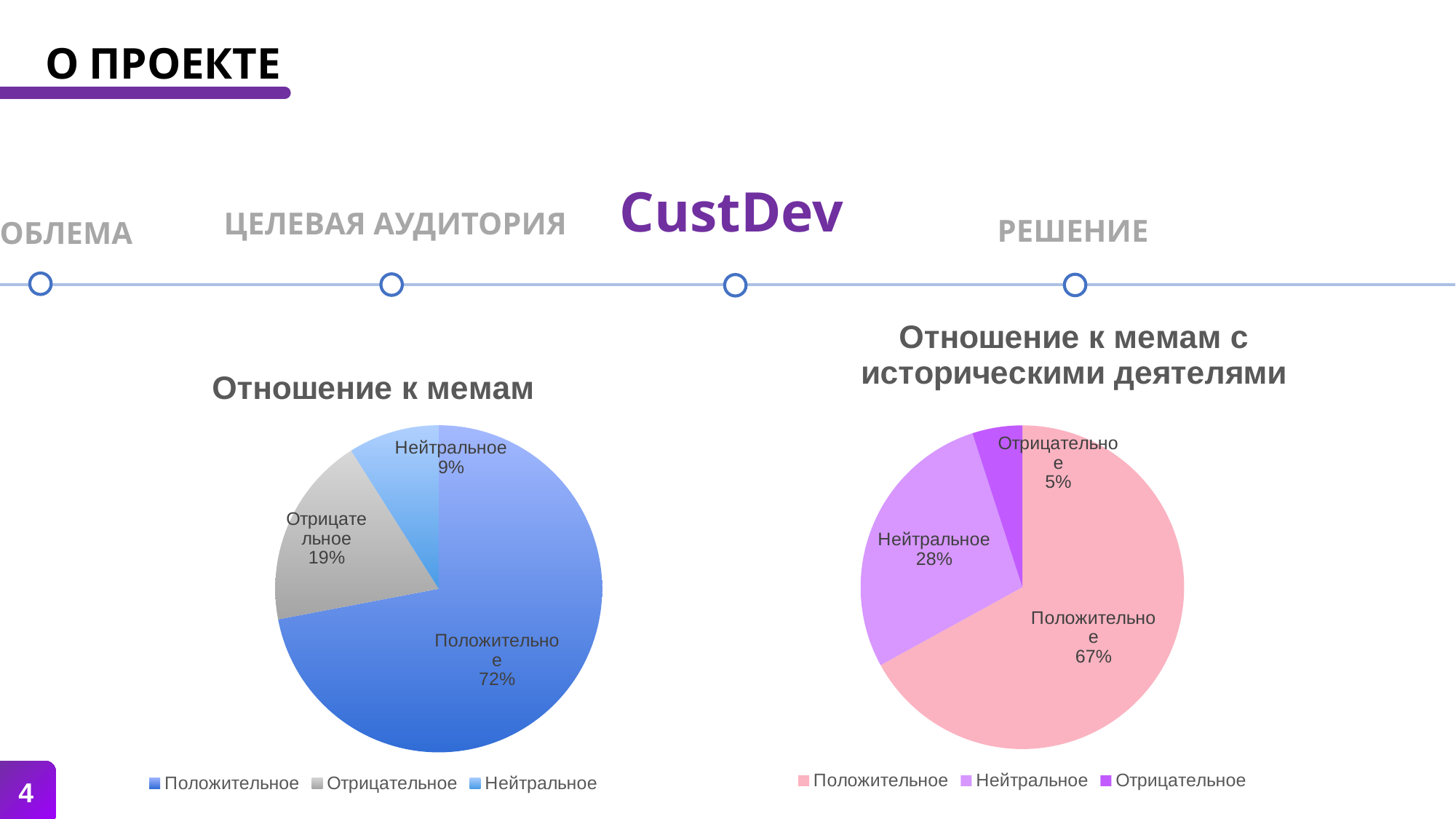
In the chart titled "Отношение к мемам с историческими деятелями", what share is labelled for Положительное? 67% How many categories does the legend of the chart titled "Отношение к мемам с историческими деятелями" list? 3 In the chart titled "Отношение к мемам с историческими деятелями", what share is labelled for Нейтральное? 28% In the chart titled "Отношение к мемам с историческими деятелями", what share is labelled for Отрицательное? 5% What kind of chart is the chart titled "Отношение к мемам"? Pie chart In the chart titled "Отношение к мемам", what share is labelled for Нейтральное? 9% In the chart titled "Отношение к мемам", which category has the largest slice? Положительное In the chart titled "Отношение к мемам", what share is labelled for Положительное? 72% In the chart titled "Отношение к мемам", what is the difference in percentage points between Отрицательное and Нейтральное? 10 In the chart titled "Отношение к мемам", what share is labelled for Отрицательное? 19% In the chart titled "Отношение к мемам с историческими деятелями", which category has the smallest slice? Отрицательное In the chart titled "Отношение к мемам с историческими деятелями", which is larger: Нейтральное or Отрицательное? Нейтральное